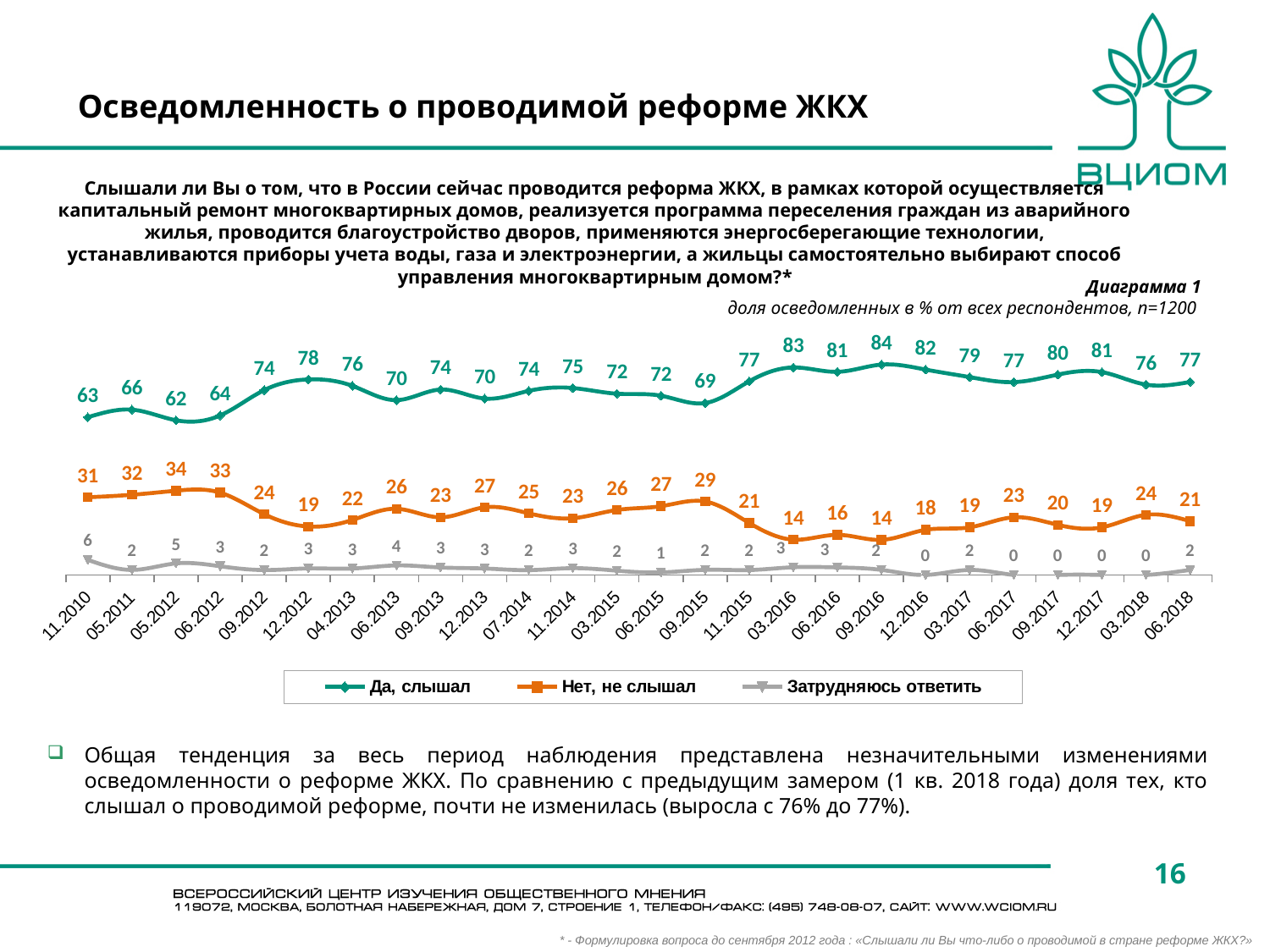
How many series does the legend list? 3 At which date does the "Да, слышал" series have its lowest value? 05.2012 At which date does the "Да, слышал" series reach its highest value? 09.2016 By how much did the "Да, слышал" value change from 03.2018 to 06.2018? 1 At which date does the "Нет, не слышал" series reach its highest value? 05.2012 What is the value for "Да, слышал" at 06.2018? 77 Which is larger for "Нет, не слышал": the value at 09.2015 or at 11.2015? 09.2015 What kind of chart is shown on the slide? Line chart What is the value for "Затрудняюсь ответить" at 11.2010? 6 How many dates are plotted on the x axis? 26 What is the value for "Нет, не слышал" at 12.2012? 19 What is the difference between "Да, слышал" and "Нет, не слышал" at 06.2018? 56